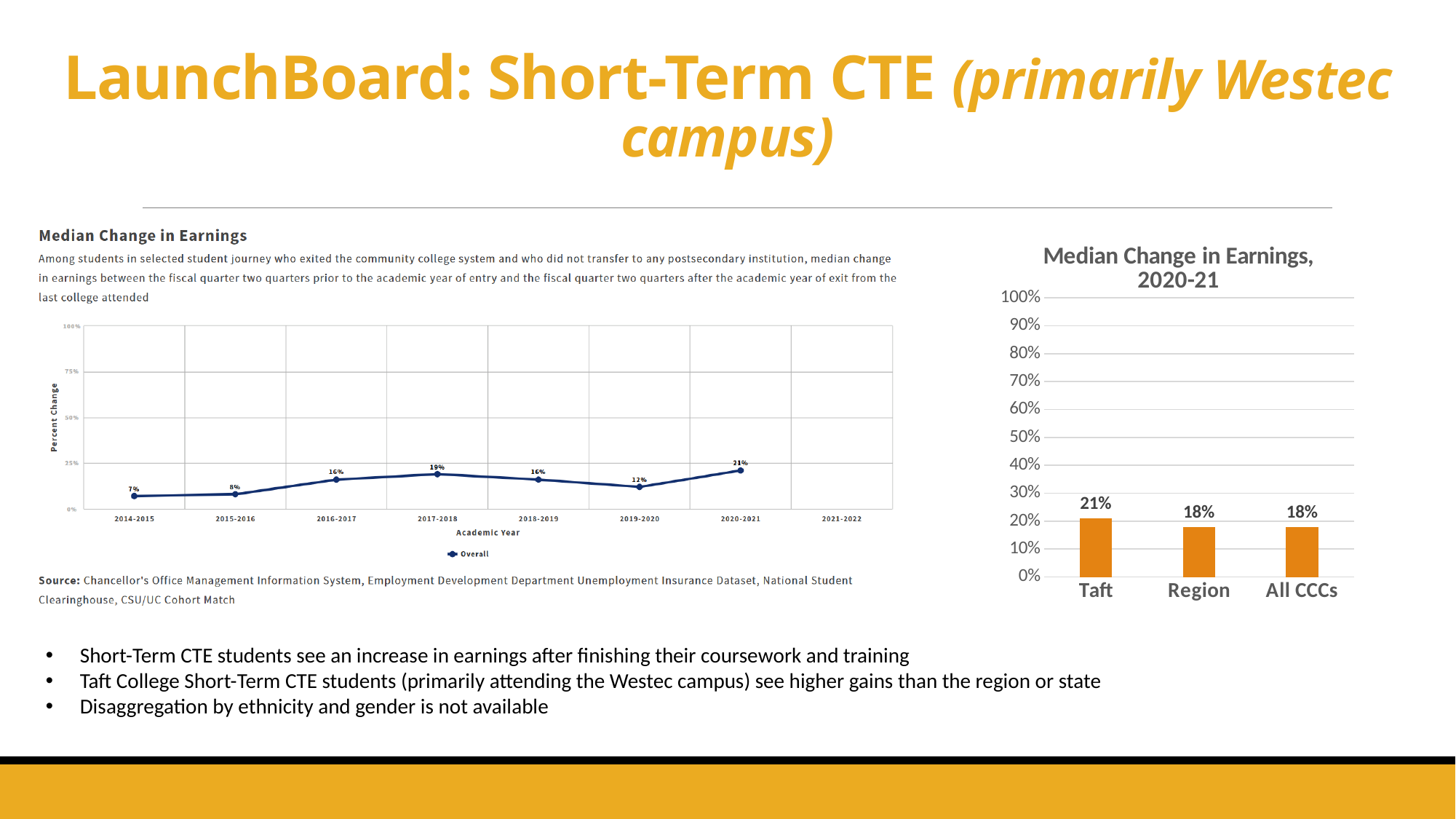
In the 'Median Change in Earnings' line chart on the left, what is the name of the series shown in the legend? Overall In the 'Median Change in Earnings' line chart on the left, what is the value for 2017-2018? 19% In the 'Median Change in Earnings, 2020-21' bar chart, what is the value for Taft? 21% What kind of chart is the 'Median Change in Earnings, 2020-21' chart on the right? Bar chart In the 'Median Change in Earnings, 2020-21' bar chart, how many categories are shown? 3 In the 'Median Change in Earnings, 2020-21' bar chart, what is the difference between Taft and All CCCs? 3% In the 'Median Change in Earnings, 2020-21' bar chart, what is the value for Region? 18% In the 'Median Change in Earnings, 2020-21' bar chart, which category has the highest value? Taft In the 'Median Change in Earnings' line chart on the left, which academic year has the lowest value? 2014-2015 In the 'Median Change in Earnings' line chart on the left, which academic year has the highest value? 2020-2021 In the 'Median Change in Earnings' line chart on the left, is the value for 2019-2020 larger or smaller than the value for 2018-2019? Smaller In the 'Median Change in Earnings' line chart on the left, what is the value for 2014-2015? 7%